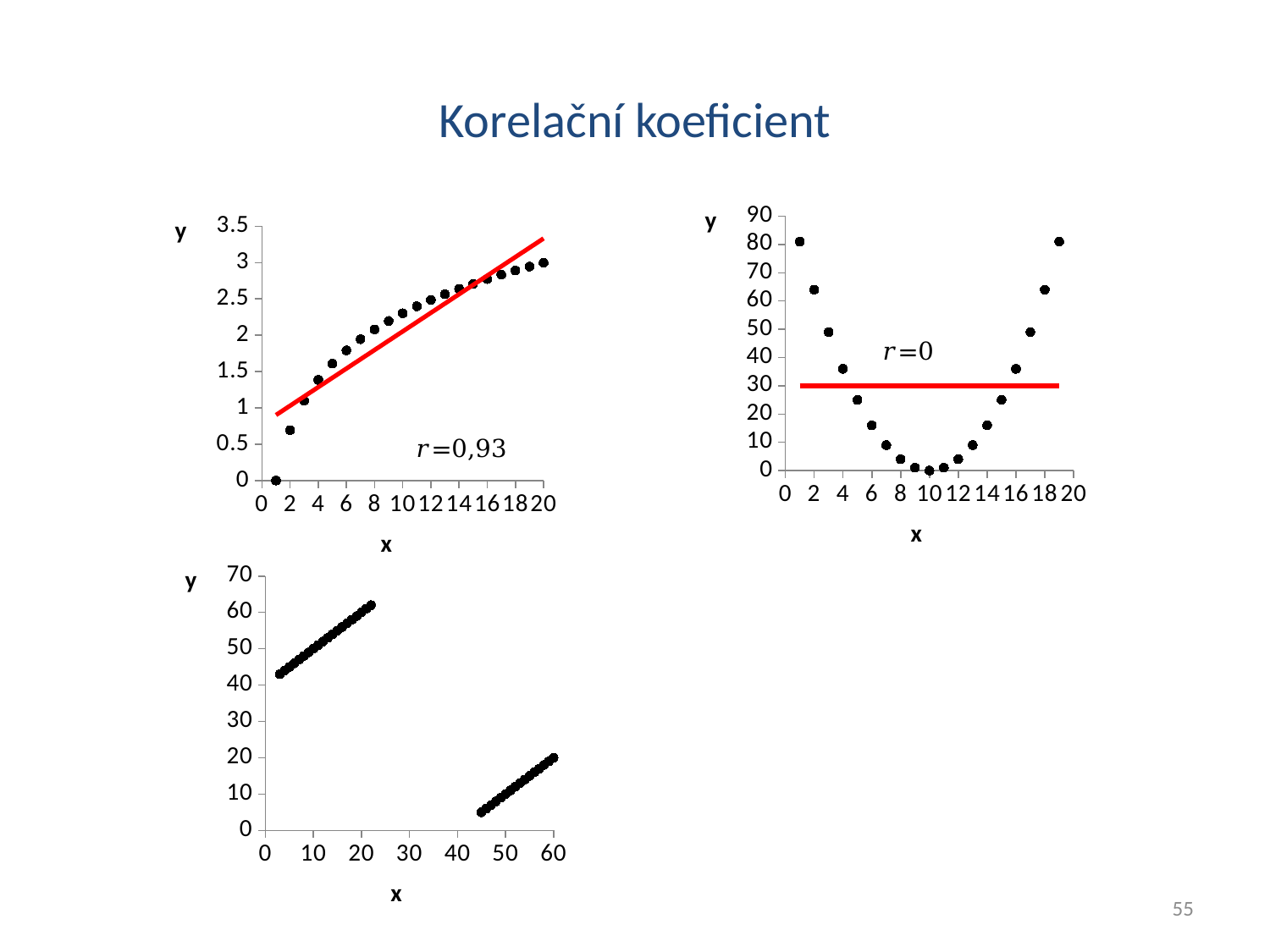
What correlation coefficient is printed on the top-left chart? r=0,93 In the top-right chart (r=0), at which x value is the y value lowest? 10 In the top-right chart (r=0), is the y value at x = 1 greater or less than 70? greater In the top-right chart (r=0), what is the y value of the point at x = 10? 0 In the top-left chart (r=0,93), what is the y value of the point at x = 1? 0 In the top-left chart (r=0,93), do the y values rise or fall as x increases? rise What kind of chart is the top-left chart (r=0,93)? scatter chart In the top-left chart (r=0,93), at which x value is the y value highest? 20 In the top-right chart (r=0), how many data points are plotted? 19 How many charts are shown on the slide? 3 In the top-right chart (r=0), which point has the larger y value: x = 1 or x = 5? x = 1 In the bottom-left chart, is the y value at x = 10 greater or less than 40? greater